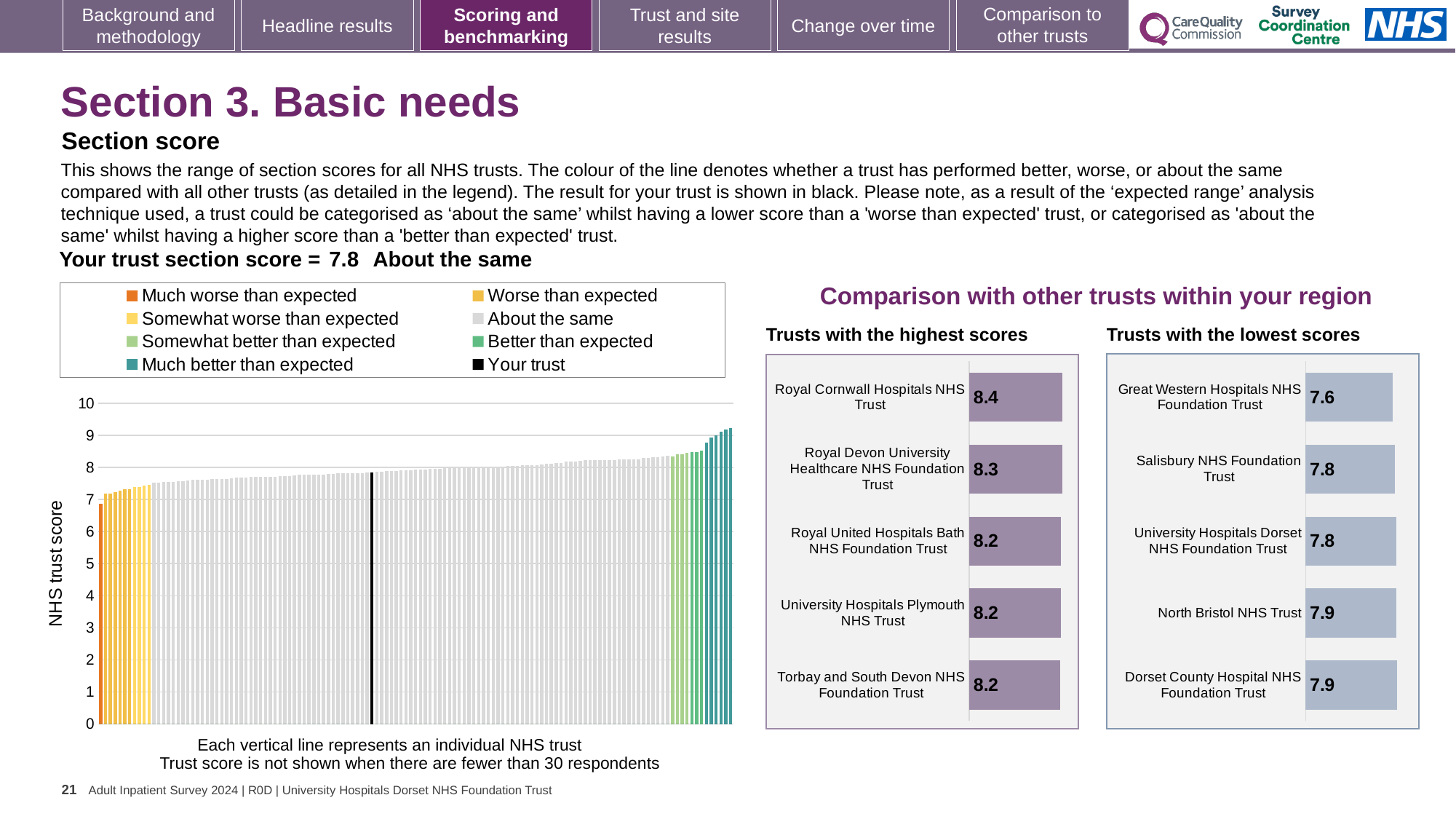
In the 'Trusts with the lowest scores' chart, what is the score for North Bristol NHS Trust? 7.9 In the 'Trusts with the highest scores' chart, what is the score for Royal Devon University Healthcare NHS Foundation Trust? 8.3 In the large chart on the left showing NHS trust scores, how many entries does the legend list? 8 What kind of chart is the large chart on the left showing NHS trust scores? Bar chart In the 'Trusts with the lowest scores' chart, what is the score for Great Western Hospitals NHS Foundation Trust? 7.6 In the 'Trusts with the highest scores' chart, which trust has the highest score? Royal Cornwall Hospitals NHS Trust In the large chart on the left showing NHS trust scores, do the values rise or fall from left to right? Rise In the 'Trusts with the highest scores' chart, how many trusts are shown? 5 In the 'Trusts with the lowest scores' chart, which trust has the lowest score? Great Western Hospitals NHS Foundation Trust In the 'Trusts with the highest scores' chart, what is the difference between the scores of Royal Cornwall Hospitals NHS Trust and Torbay and South Devon NHS Foundation Trust? 0.2 In the 'Trusts with the highest scores' chart, what is the score for Royal Cornwall Hospitals NHS Trust? 8.4 In the 'Trusts with the lowest scores' chart, what is the difference between the scores of Dorset County Hospital NHS Foundation Trust and Great Western Hospitals NHS Foundation Trust? 0.3